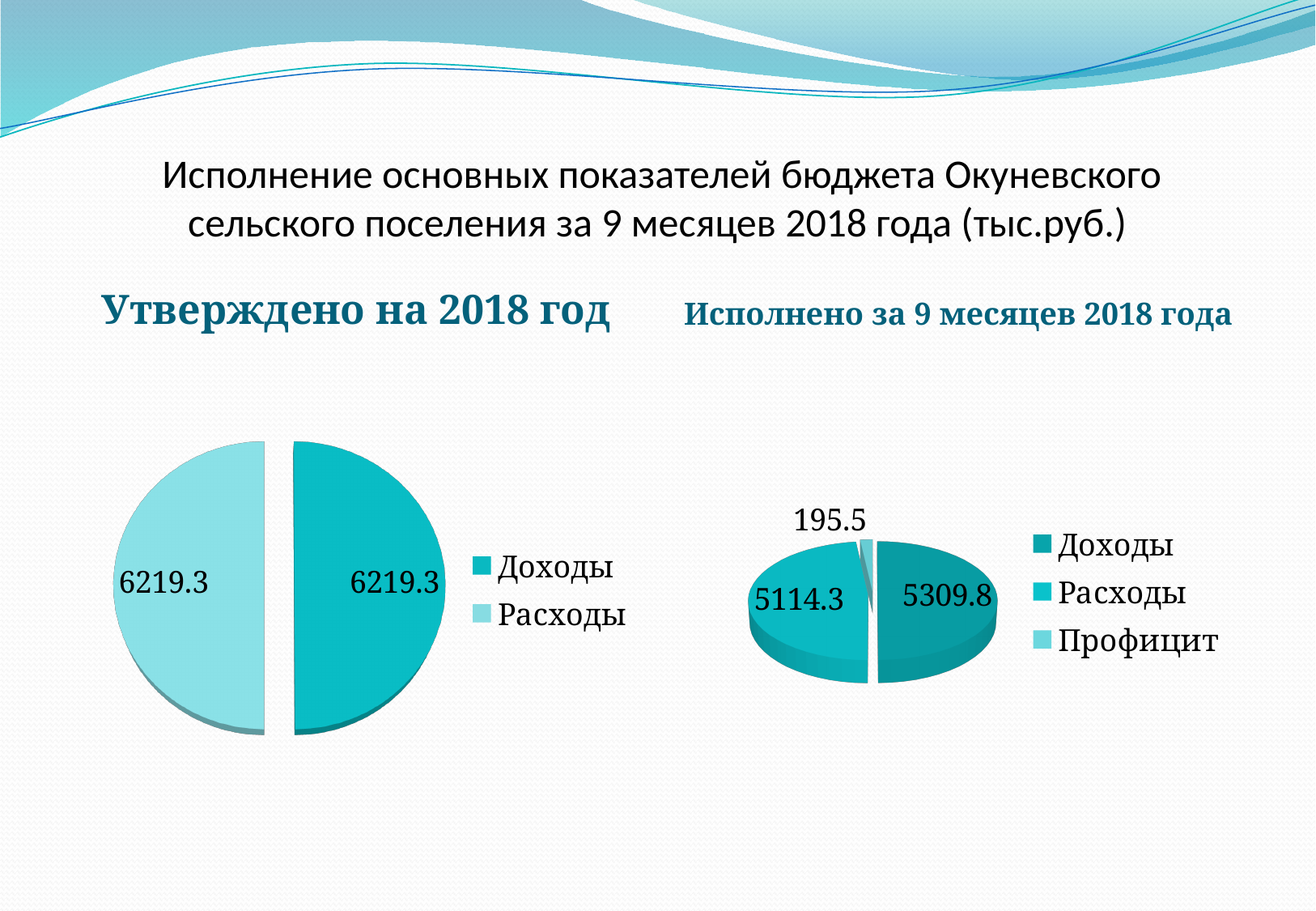
How many categories does the legend of the chart titled "Исполнено за 9 месяцев 2018 года" list? 3 In the chart titled "Исполнено за 9 месяцев 2018 года", which is larger, Доходы or Расходы? Доходы In the chart titled "Исполнено за 9 месяцев 2018 года", what is the value for Профицит? 195.5 In the chart titled "Исполнено за 9 месяцев 2018 года", what is the value for Расходы? 5114.3 In the chart titled "Исполнено за 9 месяцев 2018 года", which category has the largest value? Доходы In the chart titled "Исполнено за 9 месяцев 2018 года", what is the difference between Доходы and Расходы? 195.5 What kind of chart is the chart titled "Утверждено на 2018 год"? Pie chart In the chart titled "Утверждено на 2018 год", what is the value for Доходы? 6219.3 In the chart titled "Утверждено на 2018 год", what is the value for Расходы? 6219.3 In the chart titled "Исполнено за 9 месяцев 2018 года", what is the value for Доходы? 5309.8 In the chart titled "Исполнено за 9 месяцев 2018 года", which category has the smallest value? Профицит In the chart titled "Исполнено за 9 месяцев 2018 года", what share of the pie does Доходы represent? 50%